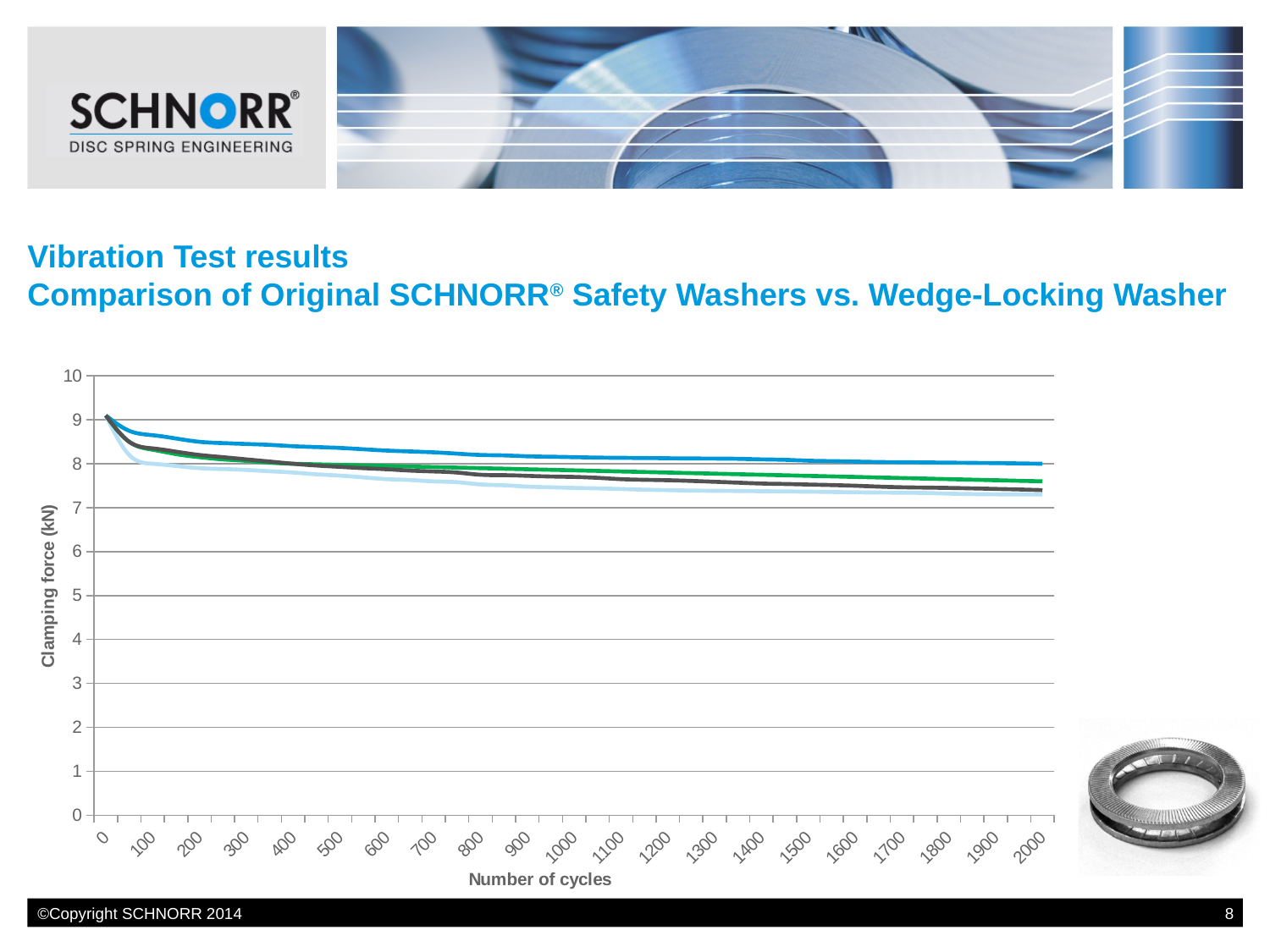
Is the value of the green line at 2000 cycles greater or less than 8? less Do the plotted lines rise or fall as the number of cycles increases? fall Is the value of the lines at 0 cycles greater or less than 8? greater At 2000 cycles, which is larger: the value of the dark blue line or the value of the light blue line? the dark blue line How many tick labels are shown along the x axis of the chart? 21 Is the value of the light blue line at 2000 cycles greater or less than 8? less What kind of chart is shown on the slide? line chart How many lines are plotted on the chart? 4 Which line is highest at 2000 cycles? the dark blue line What is the label of the x axis of the chart? Number of cycles What is the label of the y axis of the chart? Clamping force (kN)